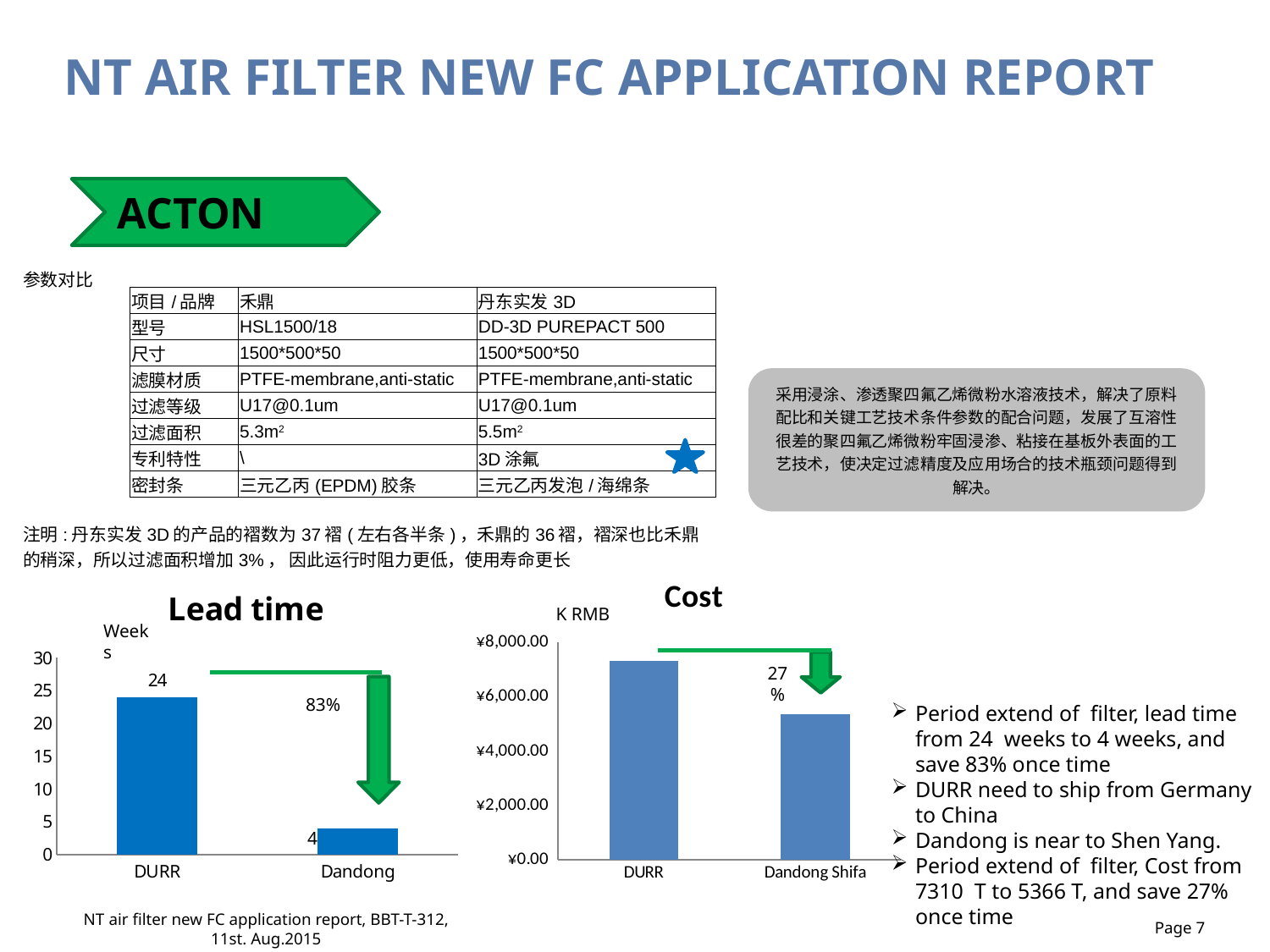
In the Lead time chart, how many categories are shown on the x axis? 2 In the Lead time chart, what unit is shown on the vertical axis label? Weeks In the Lead time chart, which category has the lowest value? Dandong In the Cost chart, is the value for DURR greater or less than ¥6,000.00? greater What kind of chart is the Cost chart? bar chart In the Cost chart, which category has the higher value? DURR In the Cost chart, is the value for Dandong Shifa greater or less than ¥6,000.00? less In the Cost chart, do the values rise or fall from DURR to Dandong Shifa? fall In the Lead time chart, what is the value for DURR? 24 In the Lead time chart, which category has the highest value? DURR In the Lead time chart, what is the difference between the DURR and Dandong values? 20 In the Lead time chart, what is the value for Dandong? 4